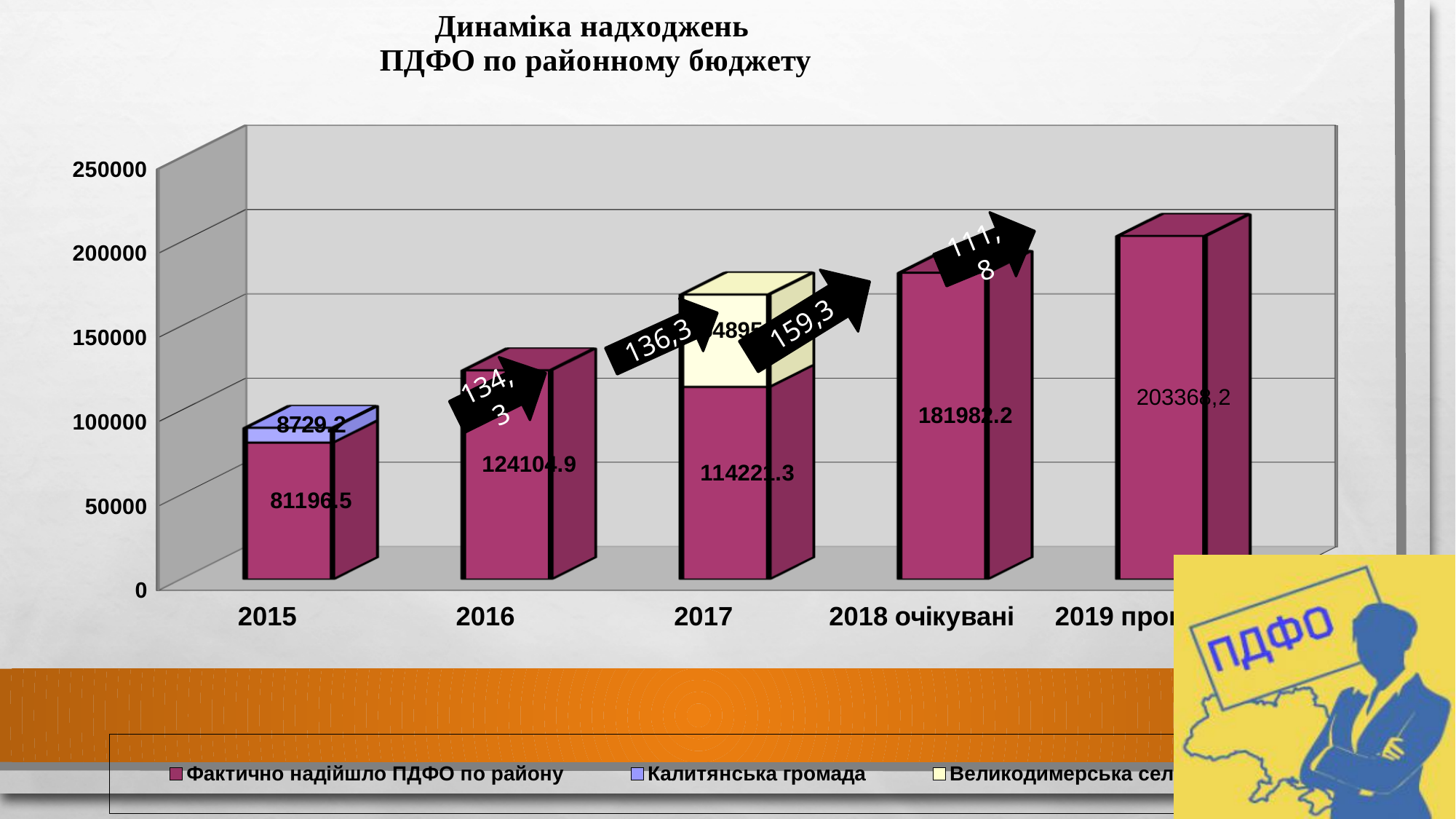
What is the value of 'Фактично надійшло ПДФО по району' for 2018 очікувані? 181982.2 What is the value of 'Фактично надійшло ПДФО по району' for 2016? 124104.9 What is the value of 'Фактично надійшло ПДФО по району' for 2015? 81196.5 How many series does the legend list? 3 What is the total of the stacked bar for 2015? 89925.7 Which year has the lowest value for 'Фактично надійшло ПДФО по району'? 2015 Does the value of 'Фактично надійшло ПДФО по району' rise or fall from 2017 to 2019? Rise What is the value of 'Калитянська громада' for 2015? 8729.2 What kind of chart is shown on the slide? Bar chart What is the value of 'Фактично надійшло ПДФО по району' for 2017? 114221.3 Which is larger for 'Фактично надійшло ПДФО по району': 2016 or 2017? 2016 What is the difference between the 'Фактично надійшло ПДФО по району' values for 2018 очікувані and 2016? 57877.3